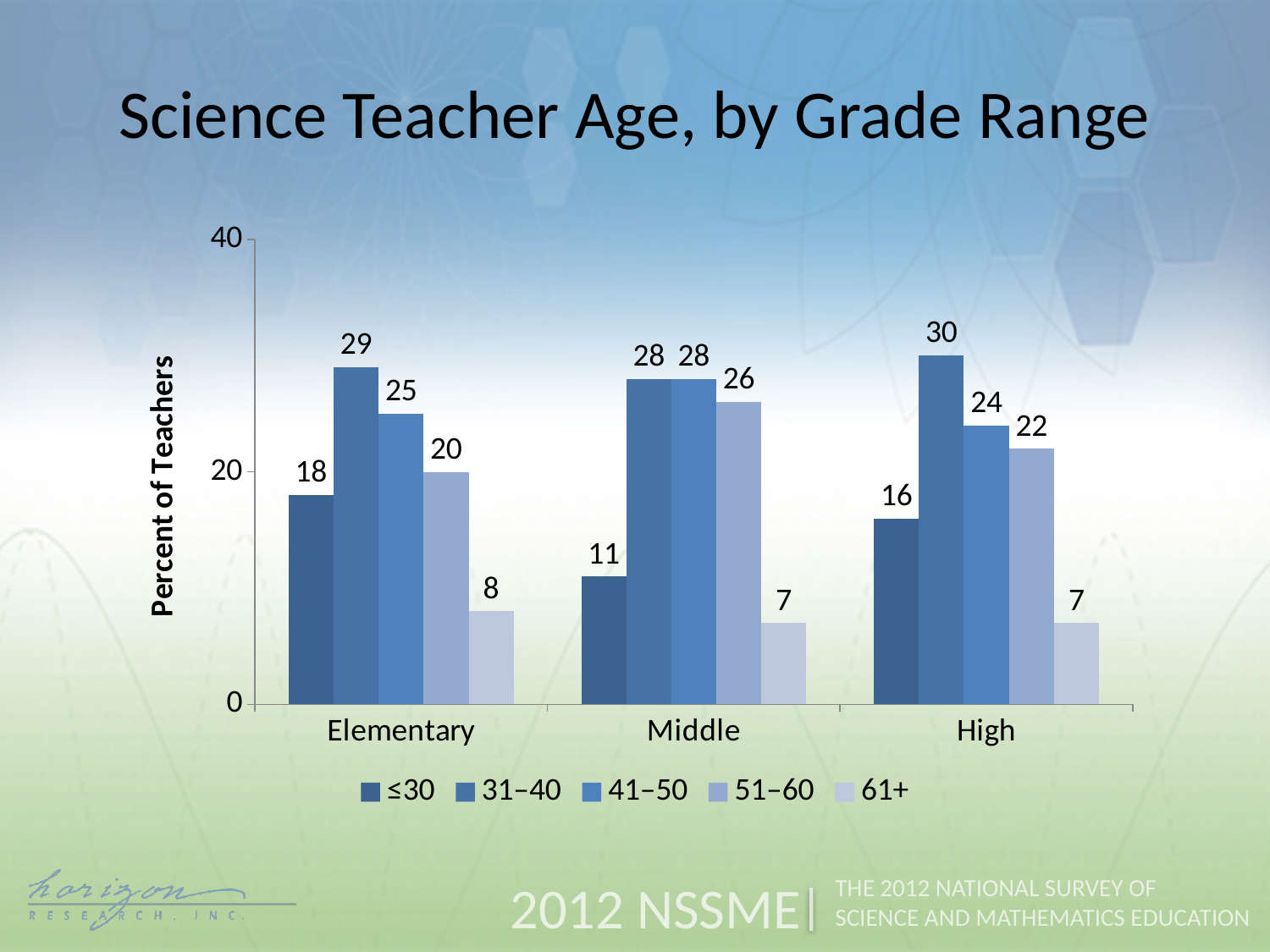
Which age group has the lowest value in the Elementary category? 61+ Which is larger: the 51–60 value for Middle or the 51–60 value for High? Middle What is the value for the 31–40 series in the Elementary category? 29 Which age group has the highest value in the High category? 31–40 Is the value for the 41–50 series in the Elementary category greater or less than 20? greater How many grade range categories are shown on the x axis? 3 What is the value for the ≤30 series in the Middle category? 11 What is the difference between the 31–40 and ≤30 values in the High category? 14 What kind of chart is shown on the slide? bar chart What is the title of the chart? Science Teacher Age, by Grade Range How many series does the legend list? 5 What is the value for the 61+ series in the High category? 7